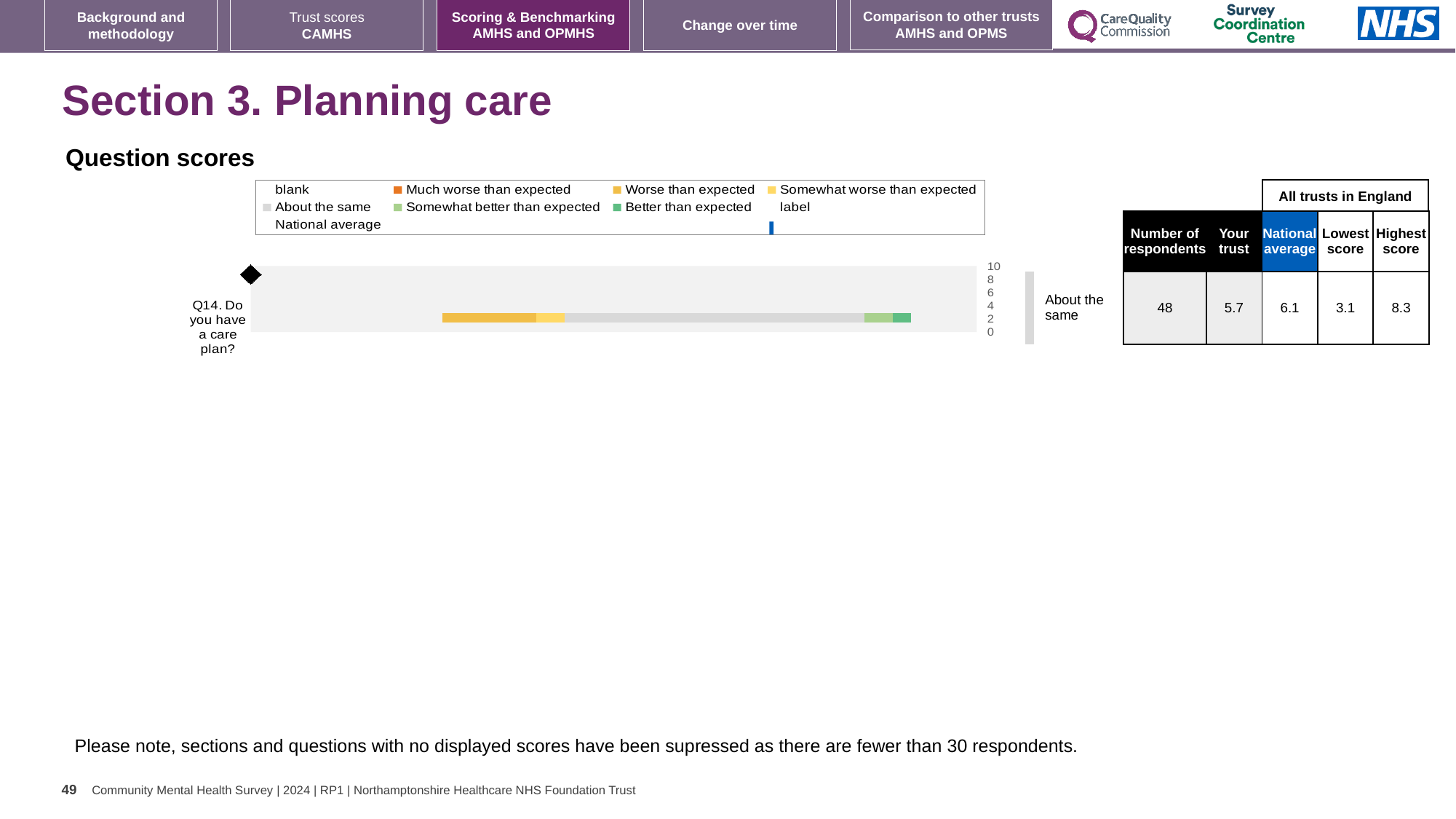
What is the difference between the highest and lowest scores for Q14 among all trusts in England? 5.2 What benchmark category is shown next to the bar for Q14? About the same How many questions are plotted in the Question scores chart? 1 What is the lowest score among all trusts in England for Q14? 3.1 What is the number of respondents for Q14? 48 Which is larger for Q14, the 'Your trust' score or the national average? National average What is the highest score among all trusts in England for Q14? 8.3 What is the difference between the national average and the 'Your trust' score for Q14? 0.4 Which question is plotted in the Question scores chart? Q14. Do you have a care plan? What is the national average score for Q14? 6.1 What is the 'Your trust' score for Q14? 5.7 What kind of chart is used to show the Q14 question score? bar chart